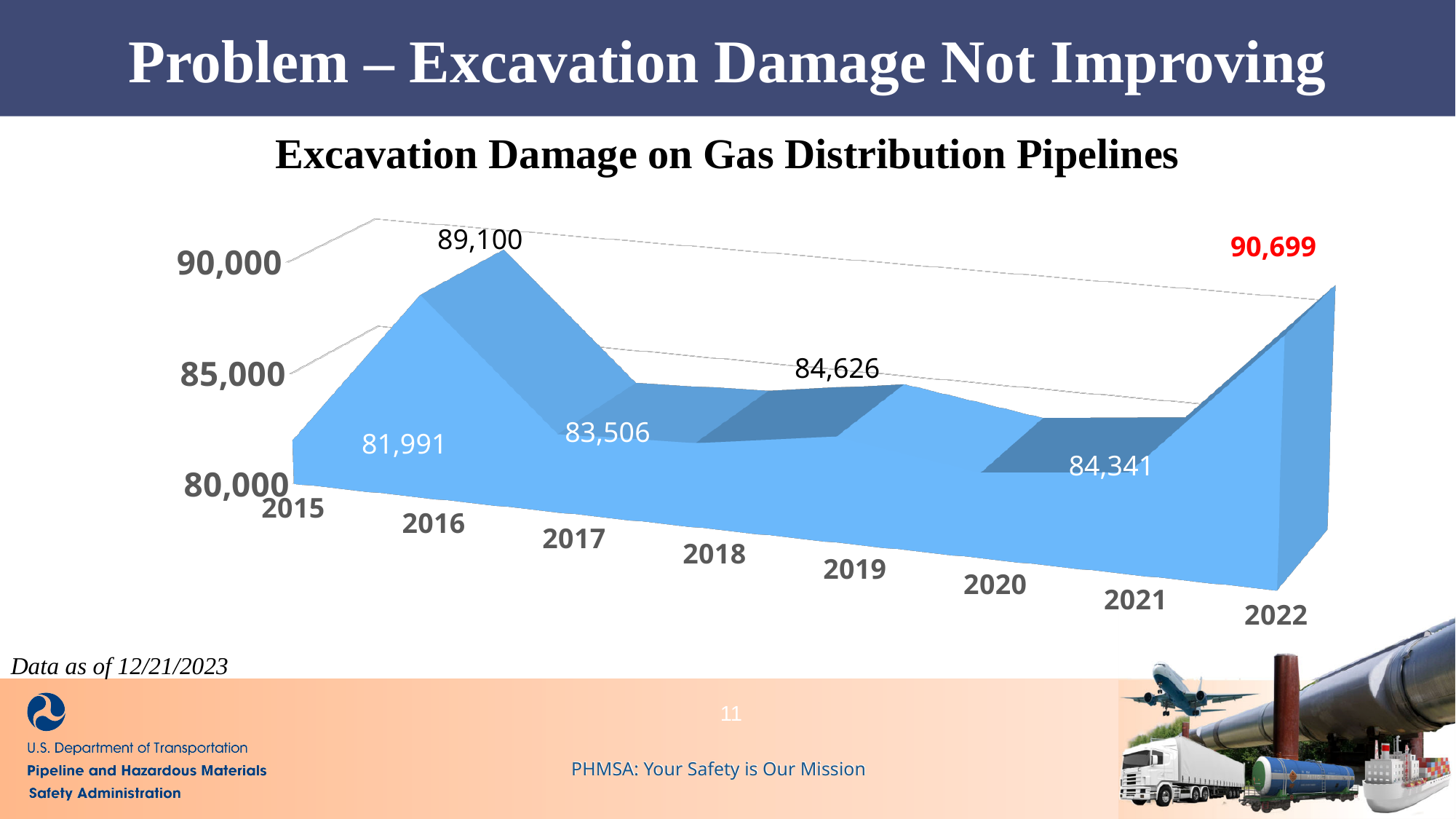
What is the value of excavation damage for 2022? 90,699 What is the title of the chart? Excavation Damage on Gas Distribution Pipelines Which year has the lowest excavation damage value? 2015 Which year's data label is shown in red? 2022 What kind of chart is shown on the slide? Area chart What is the difference between the 2022 value and the 2016 value? 1,599 Which is larger, the value for 2016 or the value for 2017? 2016 What is the value of excavation damage for 2015? 81,991 What is the value of excavation damage for 2016? 89,100 Which year has the highest excavation damage value? 2022 Is the value for 2022 greater or less than 90,000? greater How many years are plotted on the x axis of the chart? 8